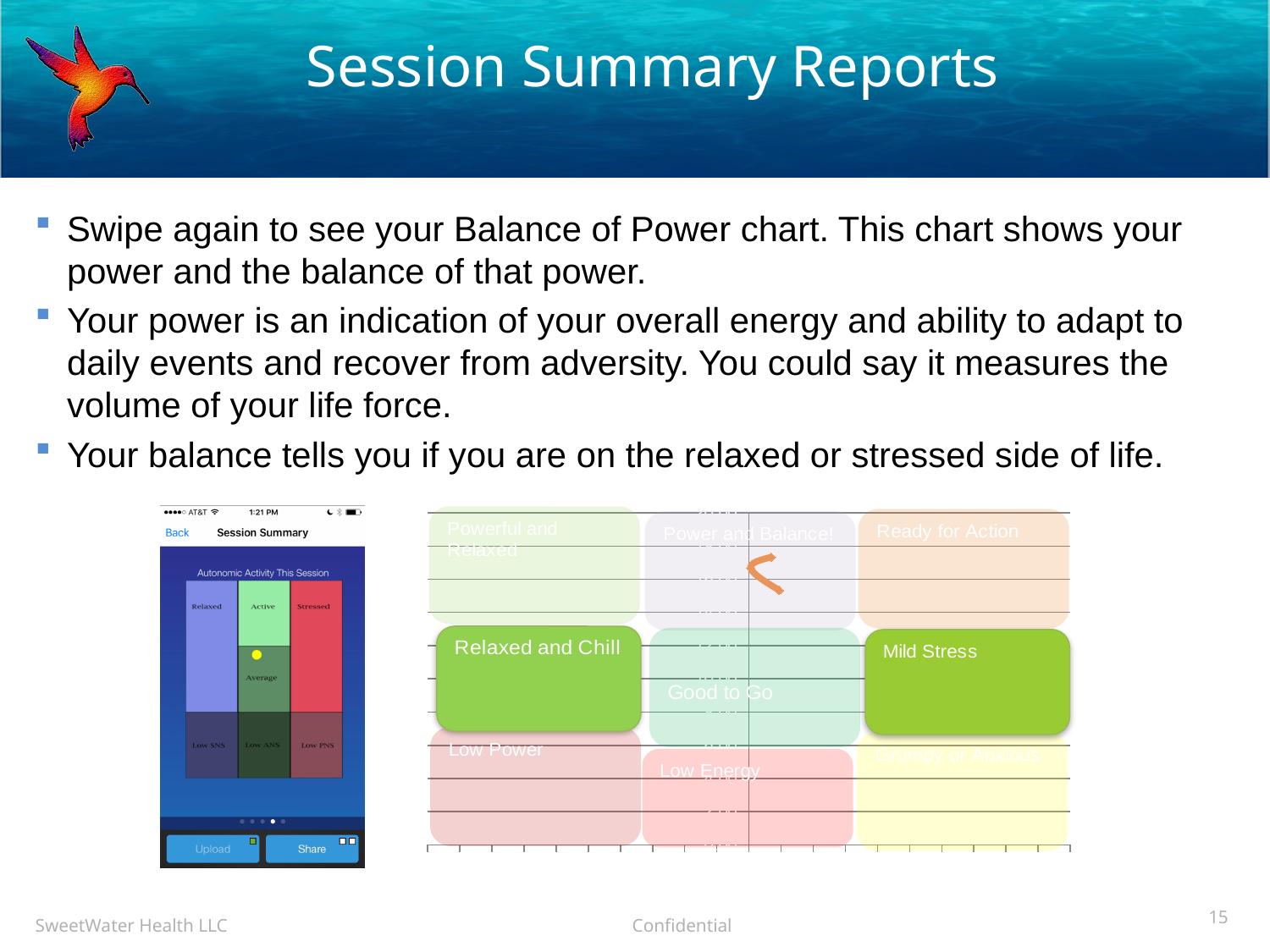
On the Balance of Power chart on the right, how many columns of zones are there? 3 On the phone screenshot chart on the left, which zone contains the yellow dot? Active On the Balance of Power chart on the right, which labeled zone contains the orange marker? Power and Balance! On the Balance of Power chart on the right, what is the label of the top-left zone? Powerful and Relaxed On the Balance of Power chart on the right, what is the label of the bottom-right zone? Grumpy or Anxious On the phone screenshot chart on the left, how many labeled zones are shown? 6 On the Balance of Power chart on the right, how many labeled zones are shown? 9 On the phone screenshot chart on the left, is the yellow dot above or below the 'Average' label? above